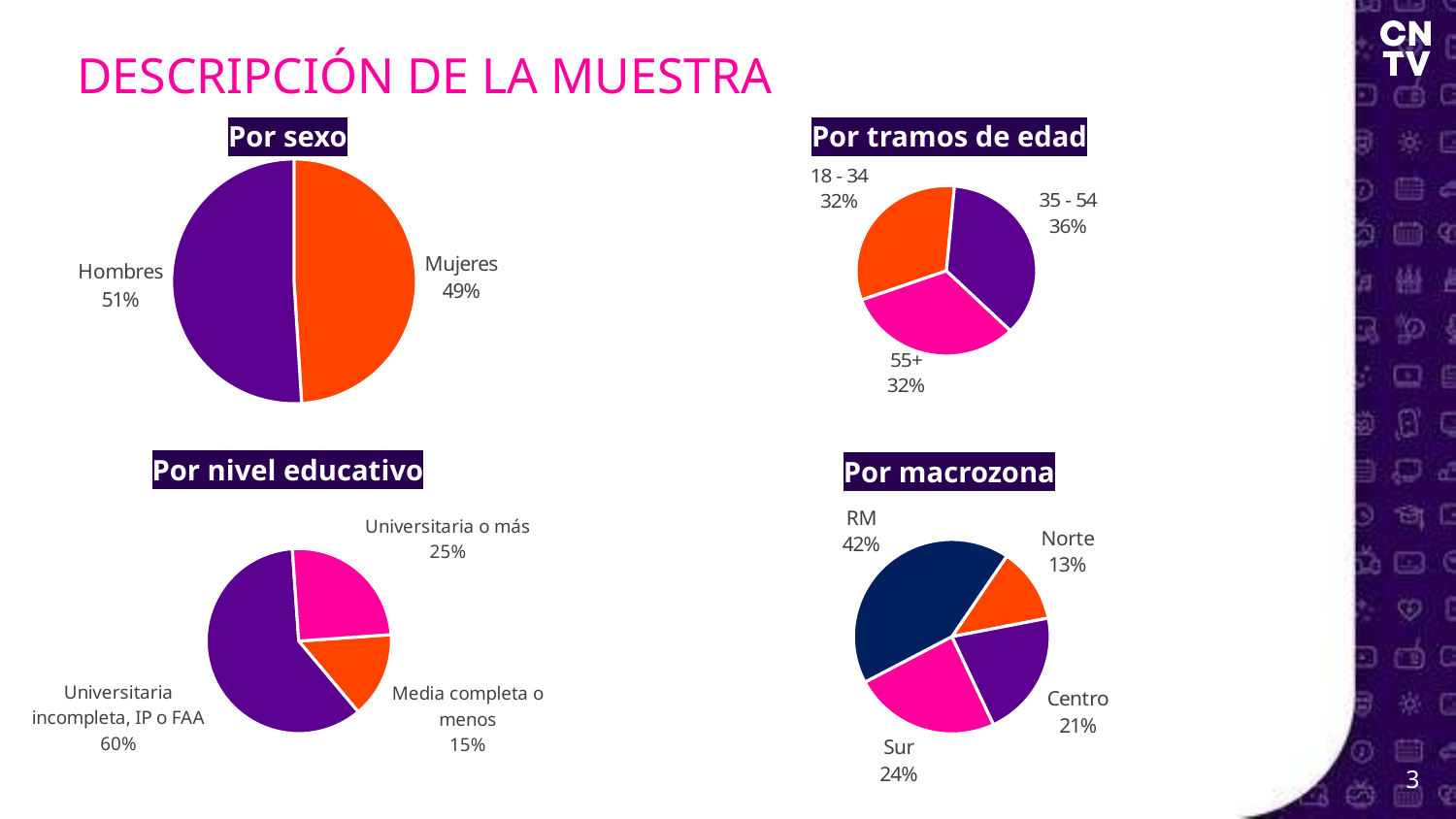
What type of chart is used for 'Por macrozona'? Pie chart In the 'Por macrozona' chart, what is the share for Sur? 24% In the 'Por nivel educativo' chart, what is the share for 'Universitaria incompleta, IP o FAA'? 60% In the 'Por sexo' chart, what is the share for Hombres? 51% In the 'Por macrozona' chart, which macrozone has the largest share? RM In the 'Por tramos de edad' chart, what is the share for the 35 - 54 group? 36% In the 'Por nivel educativo' chart, which category has the smallest share? Media completa o menos In the 'Por tramos de edad' chart, which age group has the largest share? 35 - 54 In the 'Por tramos de edad' chart, how many age groups are shown? 3 In the 'Por nivel educativo' chart, what is the difference between the shares for 'Universitaria o más' and 'Media completa o menos'? 10% In the 'Por macrozona' chart, how many macrozones are shown? 4 In the 'Por sexo' chart, which category has the larger share, Hombres or Mujeres? Hombres